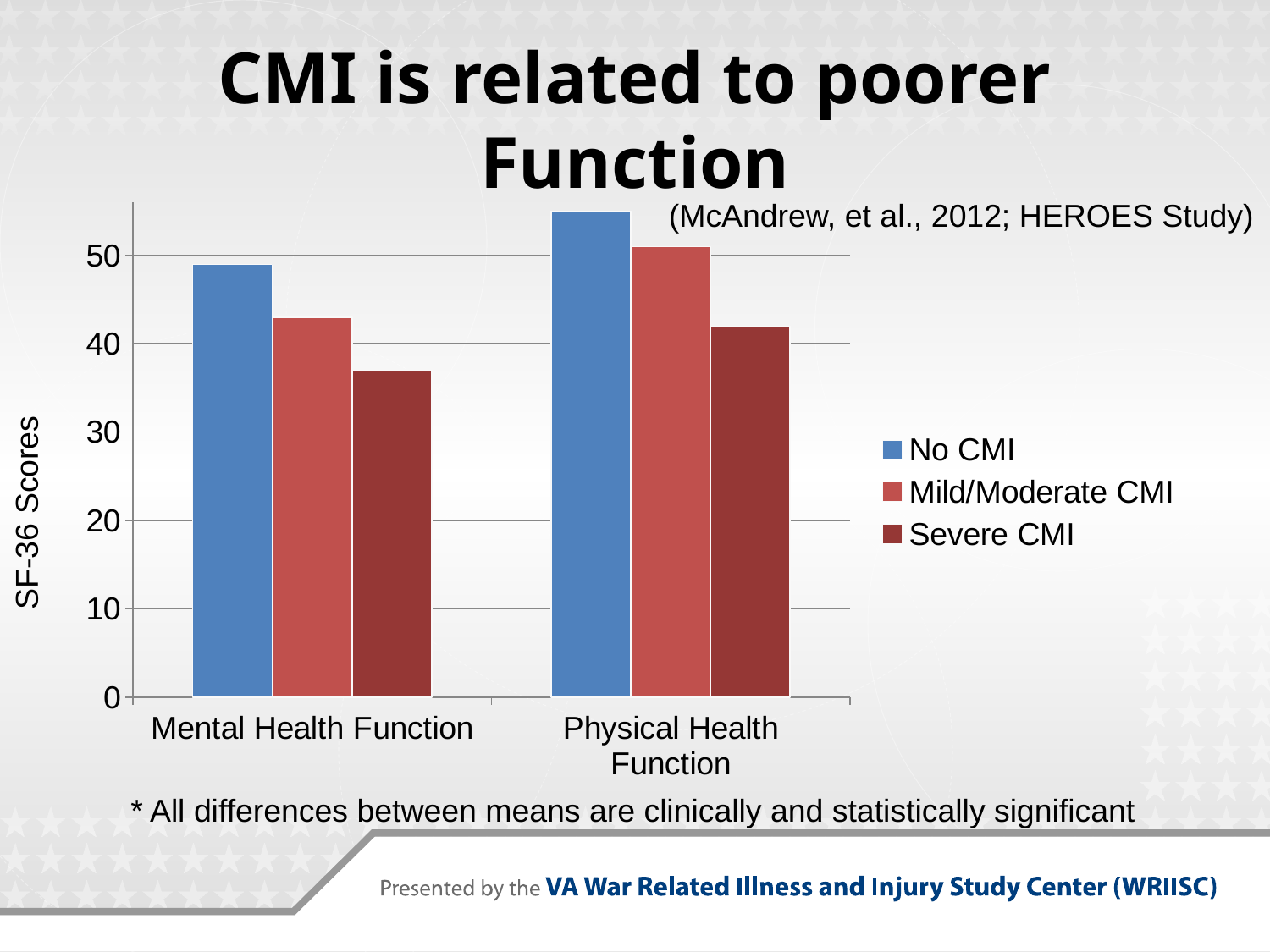
How many series does the legend list? 3 What is the label on the vertical axis of the chart? SF-36 Scores Is the value for No CMI in Physical Health Function greater or less than 50? greater Is the value for Mild/Moderate CMI in Mental Health Function greater or less than 40? greater Which is larger: the Severe CMI value for Mental Health Function or the Severe CMI value for Physical Health Function? Physical Health Function Which series has the highest bar for Mental Health Function? No CMI Is the value for Severe CMI in Physical Health Function greater or less than 40? greater Which is larger: the No CMI value for Mental Health Function or the No CMI value for Physical Health Function? Physical Health Function Which series has the lowest bar for Physical Health Function? Severe CMI How many categories are shown on the x axis? 2 What kind of chart is shown on the slide? bar chart